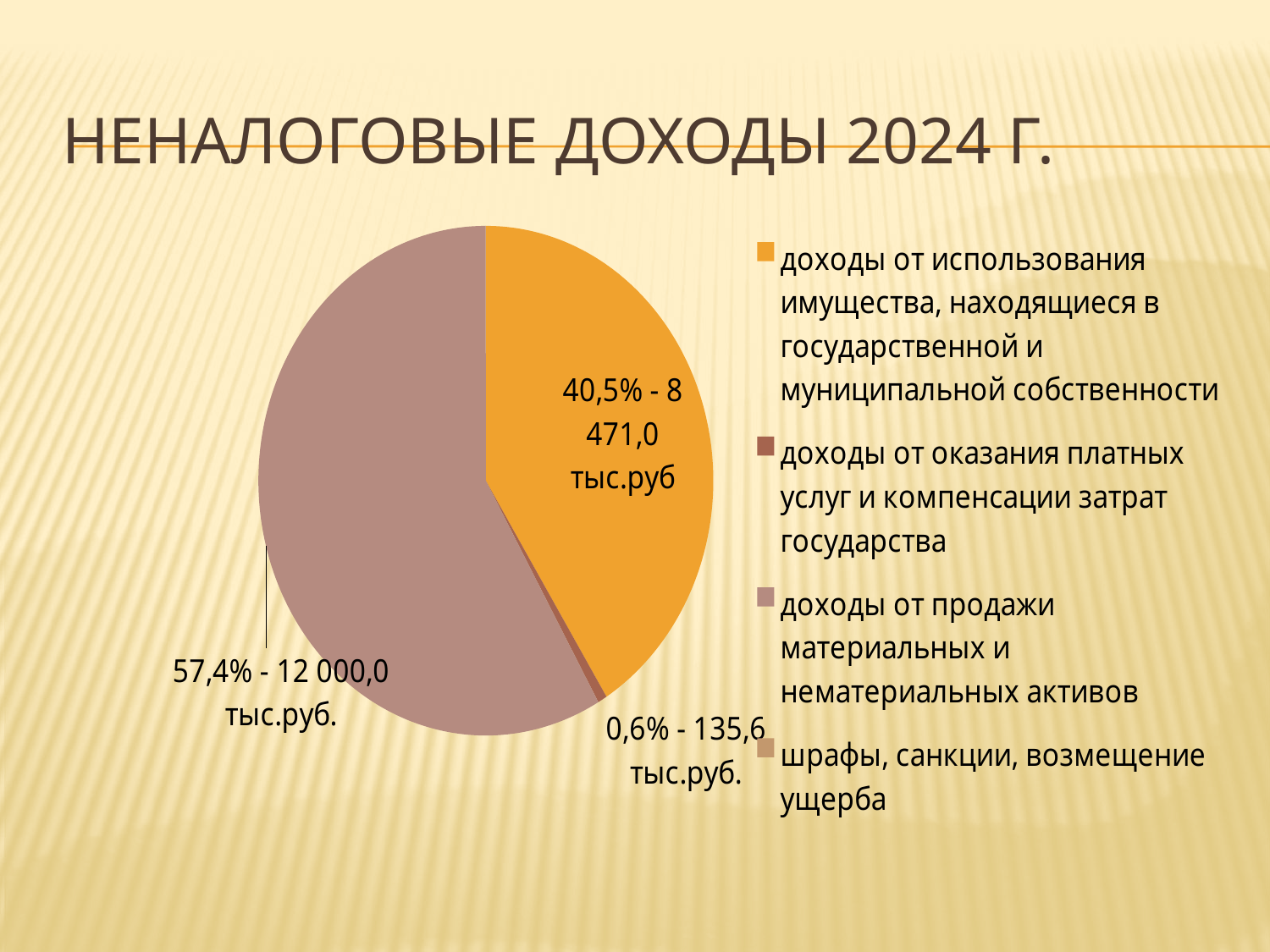
What value is shown for the slice labelled 0,6%? 135,6 тыс.руб. How many entries does the chart legend list? 4 Which legend entry is shown in orange? доходы от использования имущества, находящиеся в государственной и муниципальной собственности What percentage share does the slice for доходы от использования имущества, находящиеся в государственной и муниципальной собственности have? 40,5% Which is larger: доходы от использования имущества or доходы от продажи материальных и нематериальных активов? доходы от продажи материальных и нематериальных активов What is the title of the chart on the slide? НЕНАЛОГОВЫЕ ДОХОДЫ 2024 Г. What kind of chart is shown on the slide? pie chart What is the difference in percentage points between the 57,4% slice and the 40,5% slice? 16,9 What is the smallest percentage printed on the chart? 0,6% What is the difference in тыс.руб. between доходы от продажи материальных и нематериальных активов (12 000,0) and доходы от использования имущества (8 471,0)? 3 529,0 тыс.руб. Which category has the largest slice of the pie? доходы от продажи материальных и нематериальных активов What value is shown for доходы от продажи материальных и нематериальных активов? 12 000,0 тыс.руб.